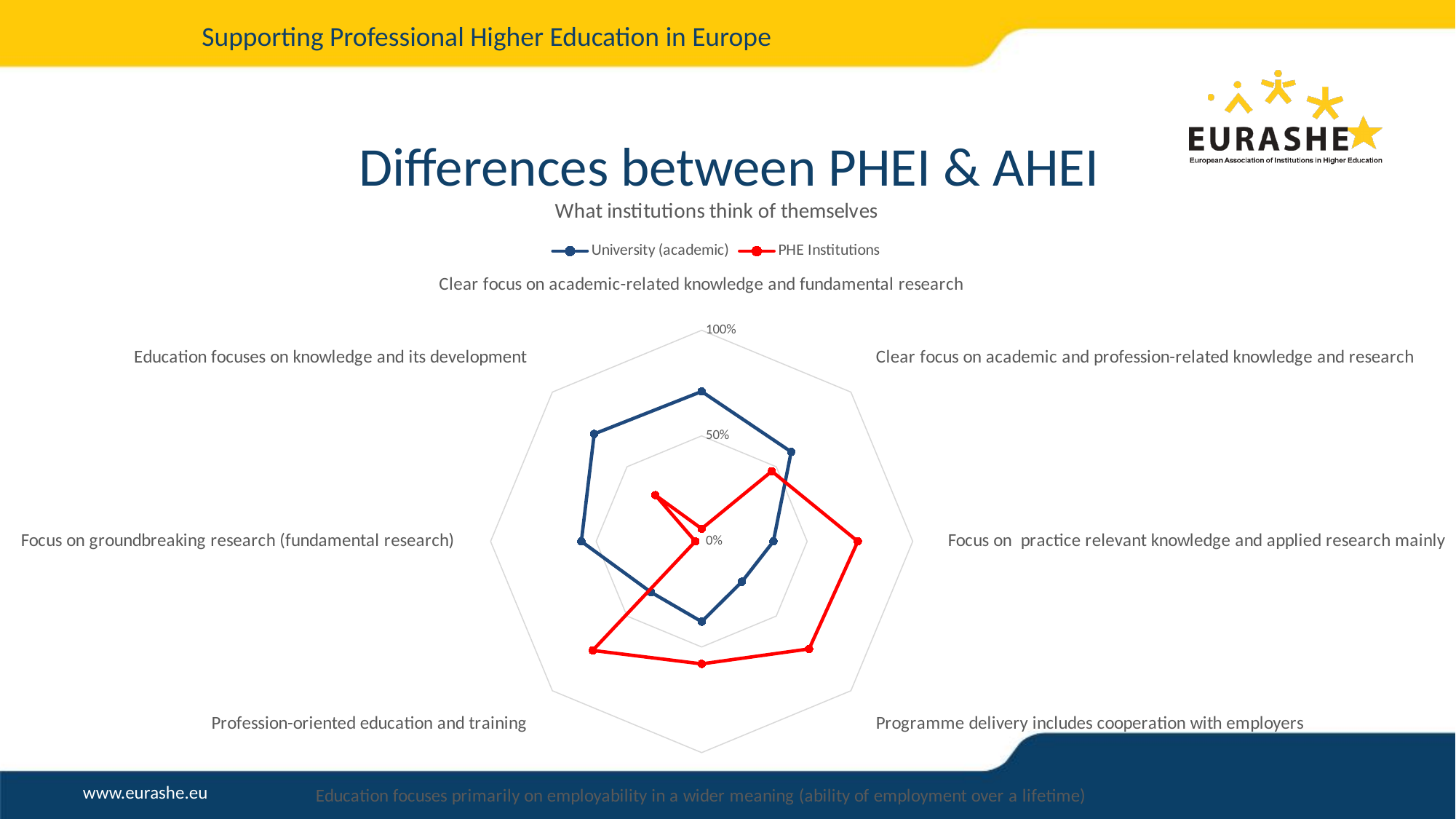
Is the University (academic) value for 'Clear focus on academic-related knowledge and fundamental research' greater or less than 50%? greater Which series has the higher value for 'Focus on groundbreaking research (fundamental research)'? University (academic) What is the subtitle shown under the chart title? What institutions think of themselves How many series does the chart legend list? 2 Which series is drawn in red? PHE Institutions Is the University (academic) value for 'Programme delivery includes cooperation with employers' greater or less than 50%? less What kind of chart is shown on the slide? Radar chart Is the PHE Institutions value for 'Focus on practice relevant knowledge and applied research mainly' greater or less than 50%? greater How many categories (axes) does the radar chart have? 8 Which series has the higher value for 'Profession-oriented education and training'? PHE Institutions Which series has the higher value for 'Education focuses on knowledge and its development'? University (academic)